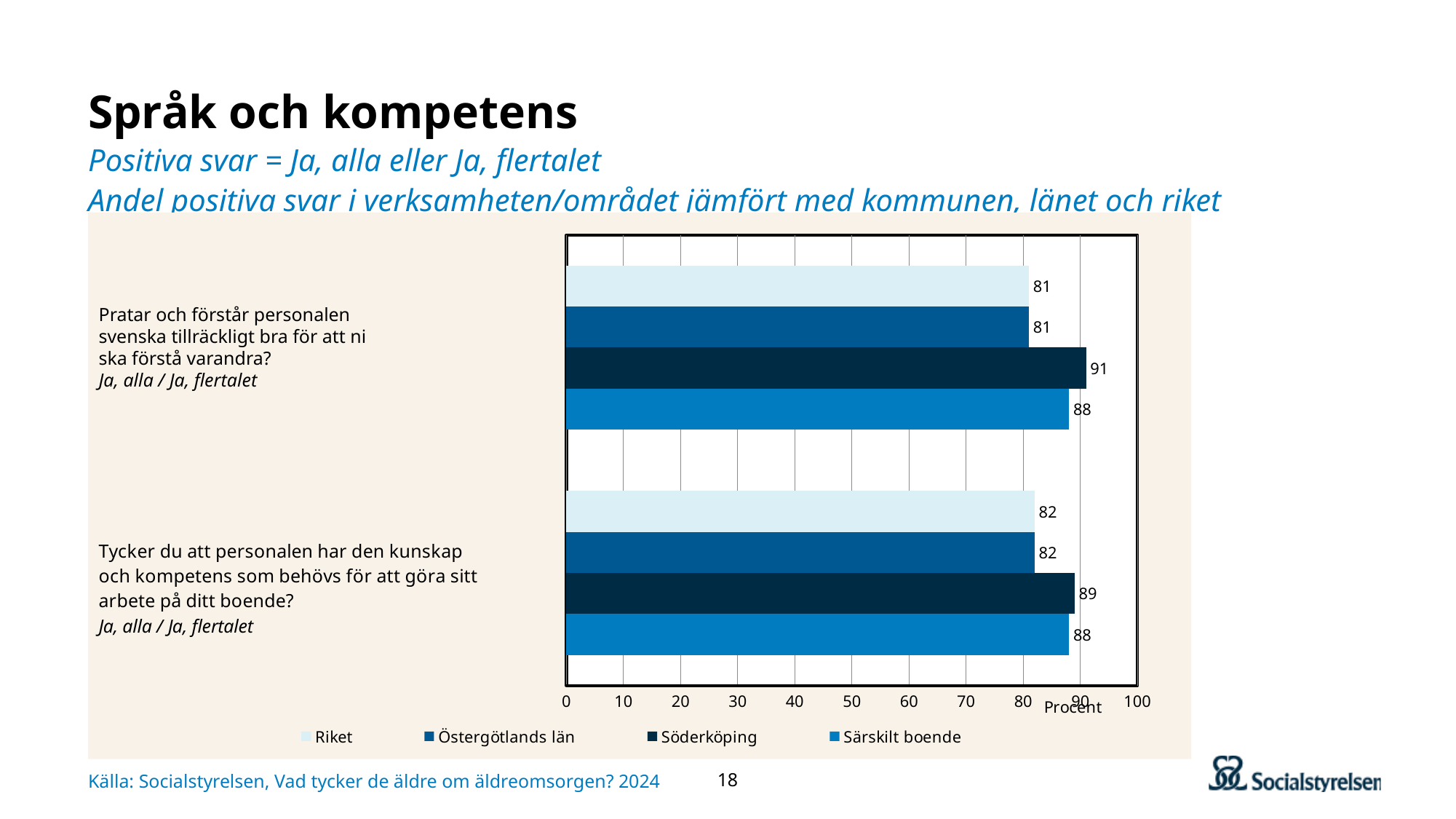
How many questions (categories) are plotted in the chart? 2 What kind of chart is shown on the slide? Bar chart What is the value for Östergötlands län on the question "Tycker du att personalen har den kunskap och kompetens som behövs för att göra sitt arbete på ditt boende?"? 82 What is the difference between Söderköping and Riket on the question "Pratar och förstår personalen svenska tillräckligt bra för att ni ska förstå varandra?"? 10 What is the value for Riket on the question "Pratar och förstår personalen svenska tillräckligt bra för att ni ska förstå varandra?"? 81 What is the difference between Söderköping and Särskilt boende on the question "Tycker du att personalen har den kunskap och kompetens som behövs för att göra sitt arbete på ditt boende?"? 1 Which is larger on the question "Pratar och förstår personalen svenska tillräckligt bra för att ni ska förstå varandra?": Söderköping or Särskilt boende? Söderköping What is the value for Särskilt boende on the question "Tycker du att personalen har den kunskap och kompetens som behövs för att göra sitt arbete på ditt boende?"? 88 Which series has the highest value on the question "Tycker du att personalen har den kunskap och kompetens som behövs för att göra sitt arbete på ditt boende?"? Söderköping What is the value for Söderköping on the question "Pratar och förstår personalen svenska tillräckligt bra för att ni ska förstå varandra?"? 91 How many series does the legend list? 4 Which series has the highest value on the question "Pratar och förstår personalen svenska tillräckligt bra för att ni ska förstå varandra?"? Söderköping